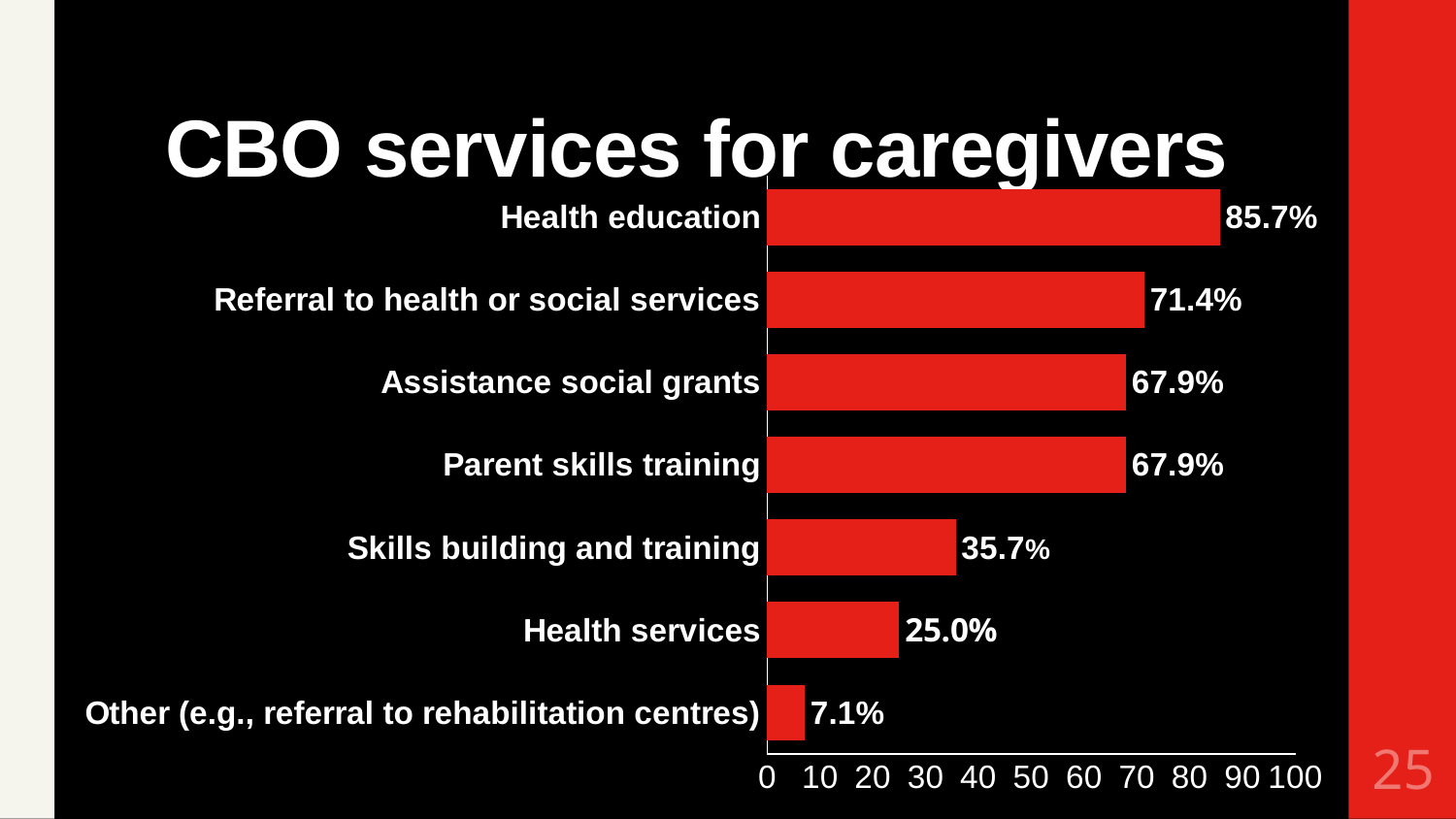
What is the value for Health education? 85.7% How many categories are shown in the chart? 7 What is the value for Other (e.g., referral to rehabilitation centres)? 7.1% Which is larger, the value for Skills building and training or the value for Health services? Skills building and training Is the value for Assistance social grants greater or less than 60? greater Which category has the lowest value? Other (e.g., referral to rehabilitation centres) What is the difference between the values for Health education and Health services? 60.7% What kind of chart is shown on the slide? Bar chart What is the value for Skills building and training? 35.7% Which category has the highest value? Health education What is the value for Referral to health or social services? 71.4% What is the title of the chart? CBO services for caregivers